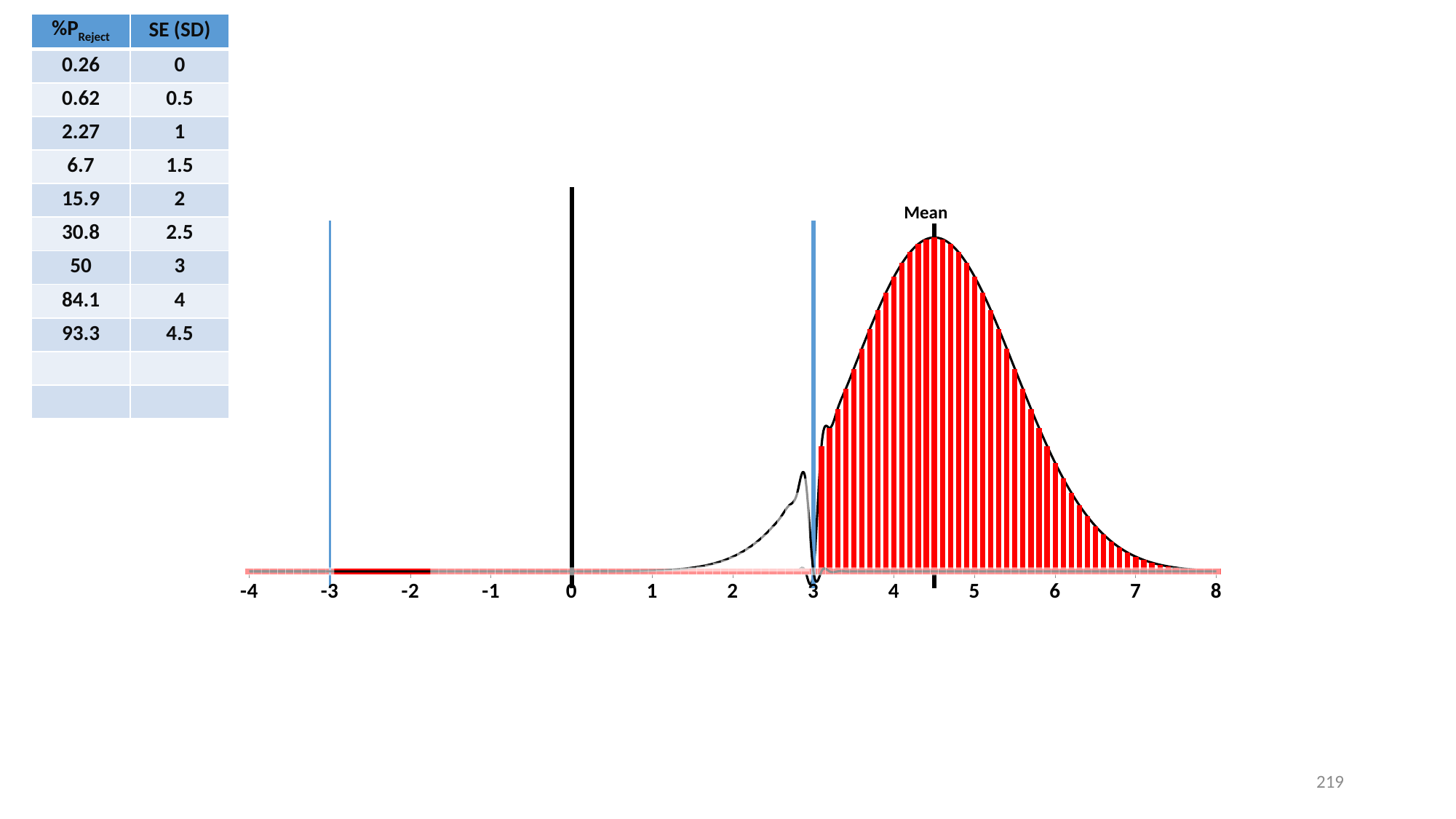
Is the shaded red area located to the left or to the right of x = 3? To the right How many tick labels are printed along the x axis? 13 Does the curve rise or fall as x increases from 3 to 4? Rises What colour are the shaded bars under the curve? Red Does the curve rise or fall as x increases from 5 to 8? Falls Is the position of the Mean marker greater or less than 4 on the x axis? greater Is the position of the Mean marker greater or less than 5 on the x axis? less What is the lowest value shown on the x axis? -4 What is the highest value shown on the x axis? 8 What label is printed above the peak of the curve? Mean At which x-axis values are the two thin blue vertical lines drawn? -3 and 3 At which x-axis value is the thick black vertical line drawn? 0